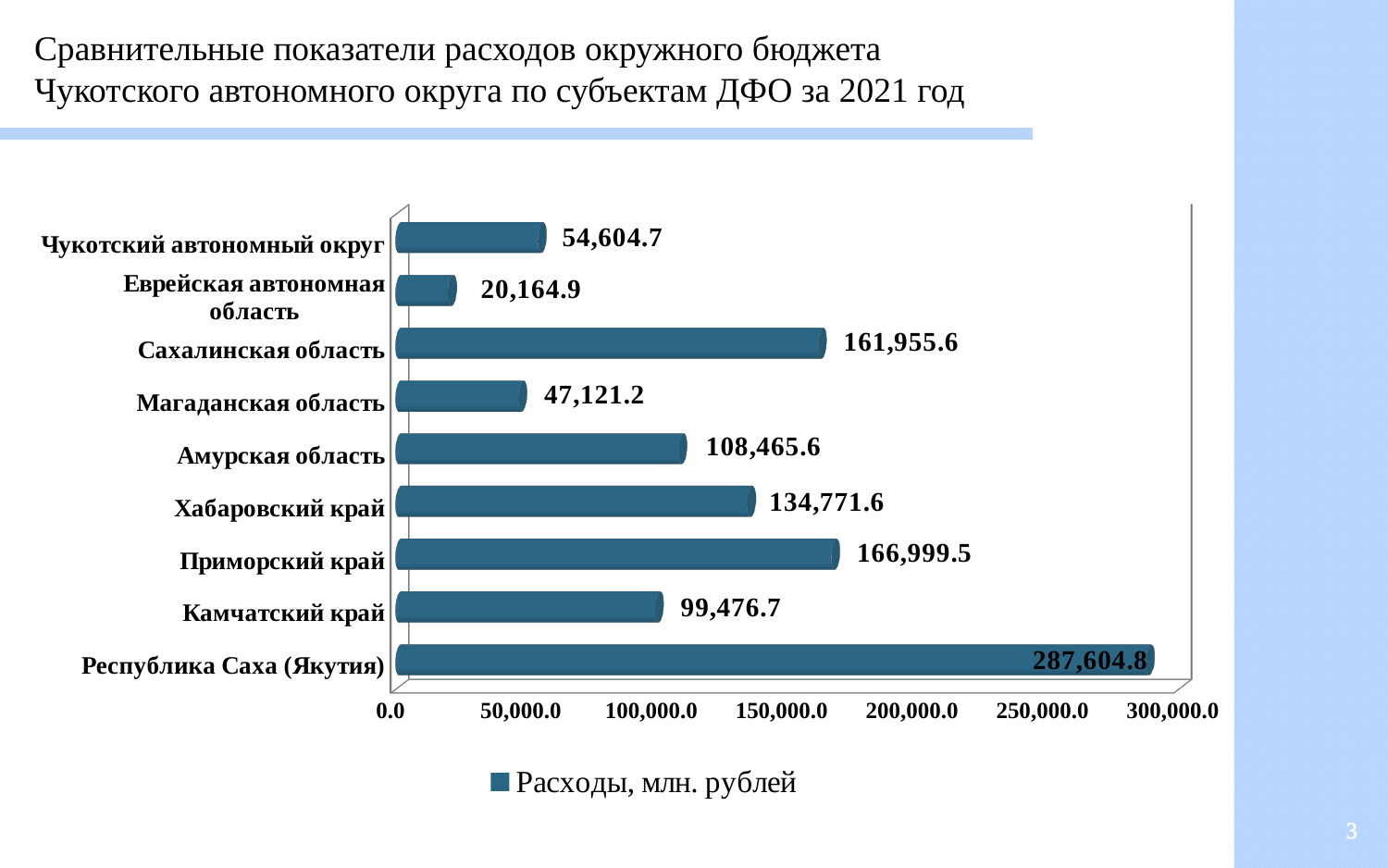
What kind of chart is shown on the slide? bar chart Which is larger, the value for Хабаровский край or the value for Амурская область? Хабаровский край What is the difference between the values for Приморский край and Сахалинская область? 5,043.9 What is the value for Камчатский край? 99,476.7 Which region has the highest value? Республика Саха (Якутия) What is the value for Сахалинская область? 161,955.6 Is the value for Республика Саха (Якутия) greater or less than 250,000.0? greater How many regions are shown in the chart? 9 Which region has the lowest value? Еврейская автономная область What is the legend entry of the chart? Расходы, млн. рублей What is the difference between the values for Чукотский автономный округ and Магаданская область? 7,483.5 What is the value for Чукотский автономный округ? 54,604.7